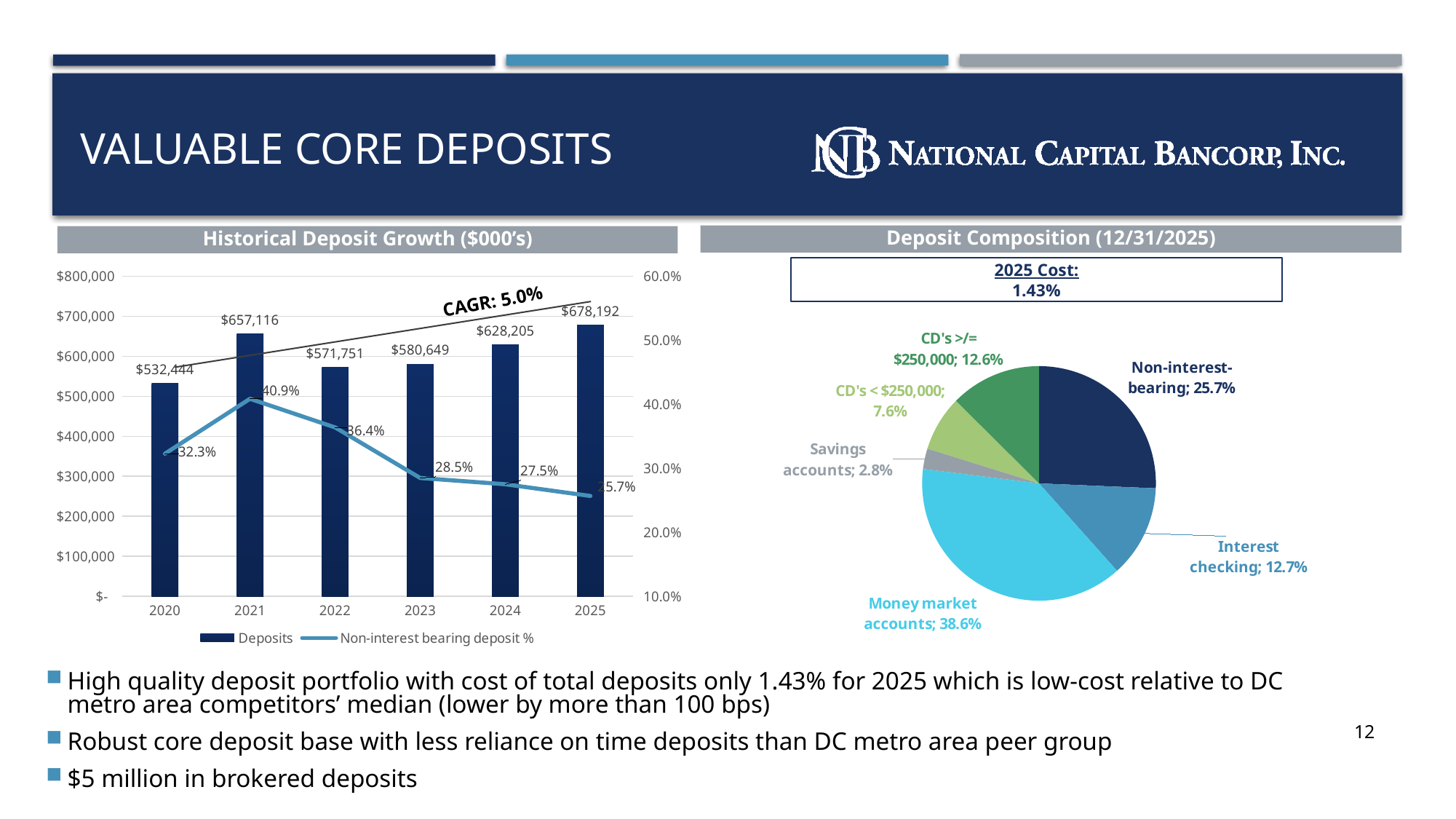
In the Deposit Composition pie chart, which category has the smallest share? Savings accounts In the Historical Deposit Growth chart, how many years are shown on the x axis? 6 In the Historical Deposit Growth chart, which year has the lowest Deposits value? 2020 In the Historical Deposit Growth chart, is the Deposits value for 2022 larger or smaller than for 2023? smaller What kind of chart is the Deposit Composition (12/31/2025) chart? pie chart In the Historical Deposit Growth chart, what is the difference in Deposits between 2025 and 2024? $49,987 In the Historical Deposit Growth chart, which year has the highest Non-interest bearing deposit %? 2021 In the Deposit Composition pie chart, what share do Money market accounts have? 38.6% In the Historical Deposit Growth chart, does the Non-interest bearing deposit % rise or fall from 2021 to 2025? fall In the Historical Deposit Growth chart, how many series does the legend list? 2 In the Historical Deposit Growth chart, what is the Deposits value for 2021? $657,116 In the Historical Deposit Growth chart, what is the Non-interest bearing deposit % for 2023? 28.5%